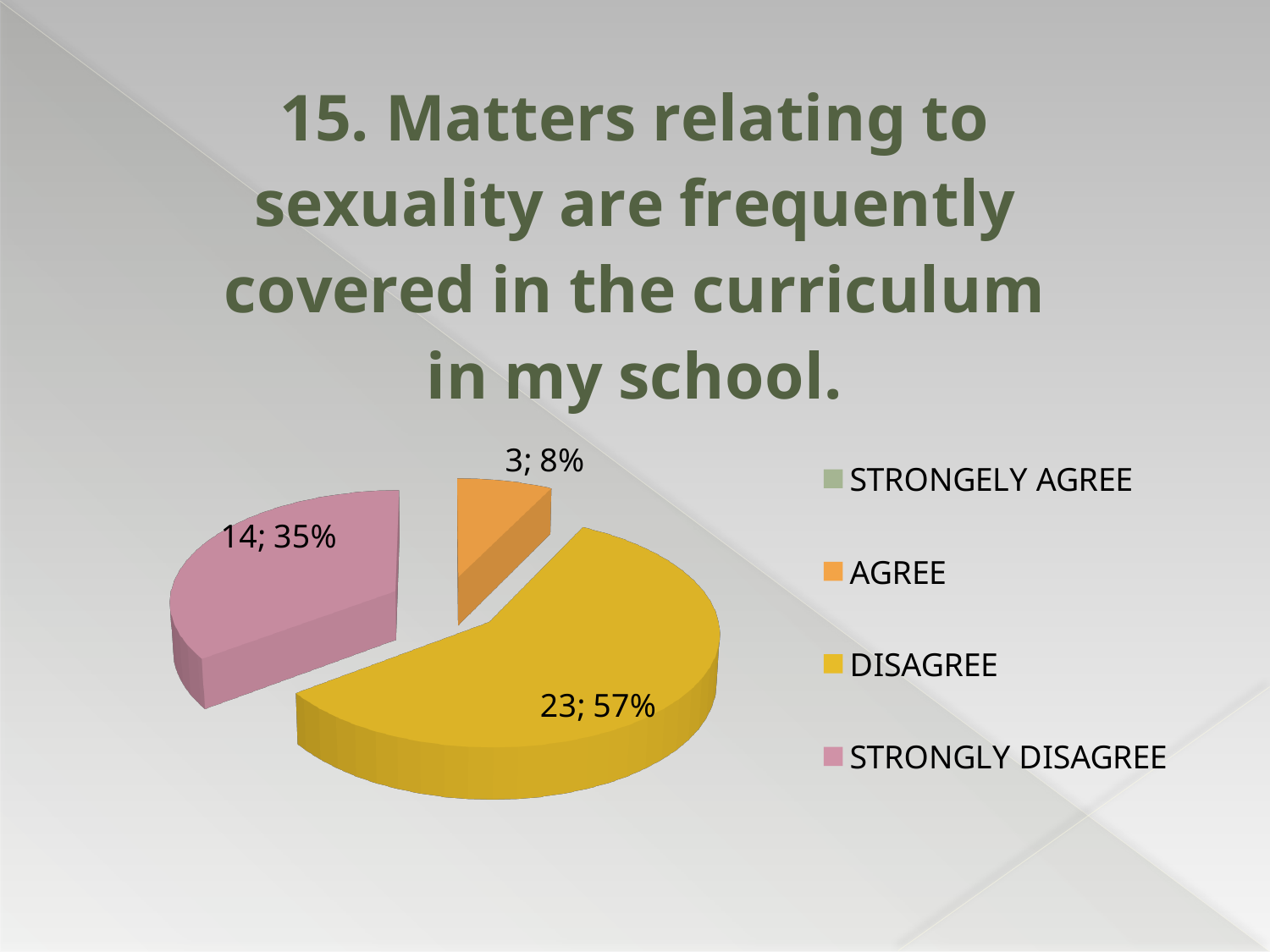
Which is larger, the AGREE slice or the STRONGLY DISAGREE slice? STRONGLY DISAGREE What is the count and percentage shown for STRONGLY DISAGREE? 14; 35% What is the difference in count between DISAGREE and STRONGLY DISAGREE? 9 What is the count and percentage shown for AGREE? 3; 8% What share of the pie does the STRONGLY DISAGREE slice represent? 35% Which visible slice of the pie is the smallest? AGREE What kind of chart is shown on the slide? Pie chart How many entries does the legend list? 4 Which category has the largest slice of the pie? DISAGREE What is the count and percentage shown for DISAGREE? 23; 57% What colour is the DISAGREE slice? Yellow What is the title of the chart? 15. Matters relating to sexuality are frequently covered in the curriculum in my school.